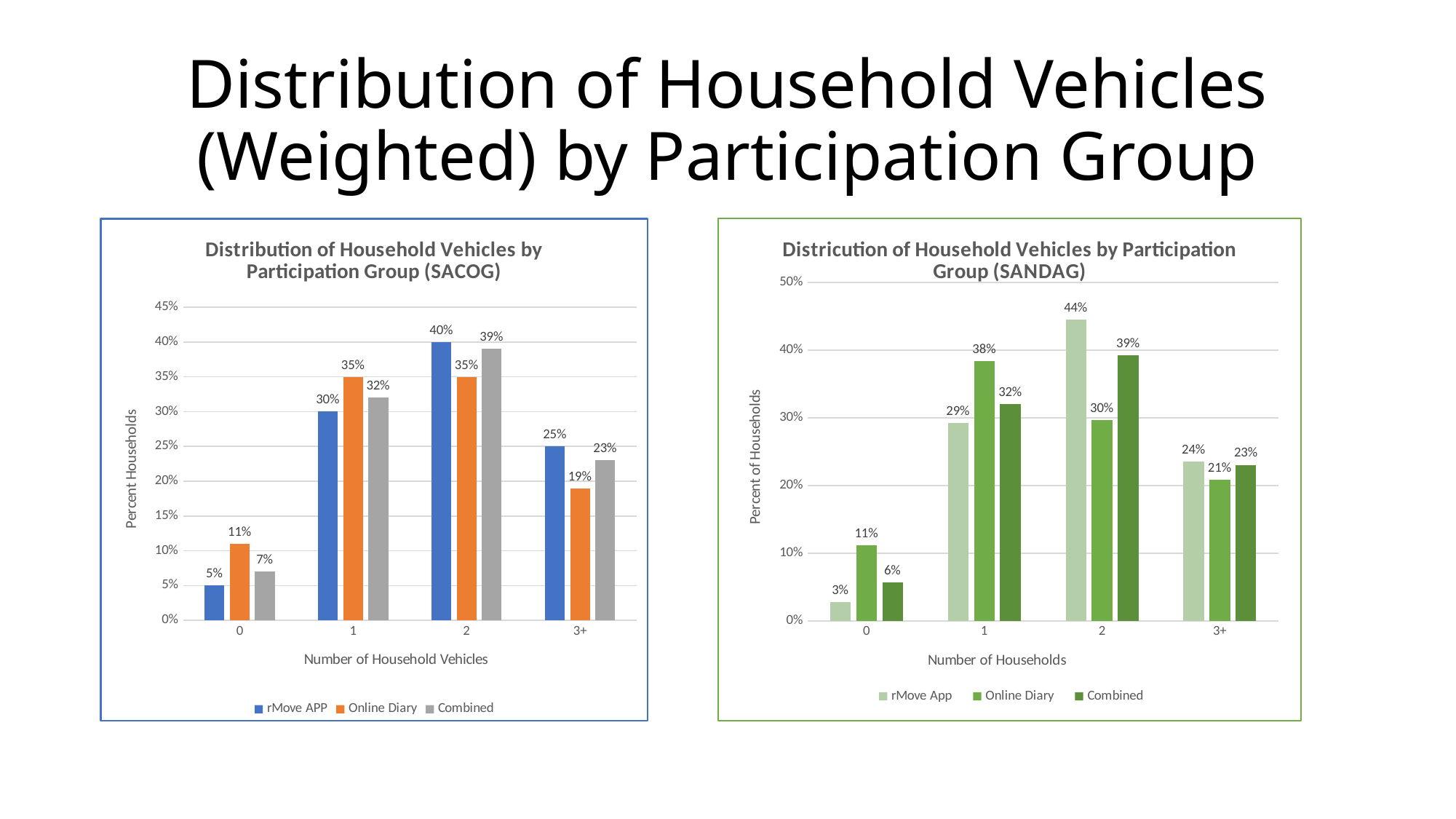
In the SACOG chart, which number of household vehicles has the lowest Online Diary value? 0 In the SANDAG chart, which number of household vehicles has the highest rMove App value? 2 In the SANDAG chart, what is the difference between the rMove App and Online Diary values at 2 household vehicles? 14% How many series does the legend of the SANDAG chart list? 3 In the SACOG chart, what is the value for rMove APP at 2 household vehicles? 40% In the SANDAG chart, which is larger at 0 household vehicles: rMove App or Combined? Combined What kind of chart is the SACOG chart? Bar chart What is the x-axis label of the SANDAG chart? Number of Households In the SANDAG chart, what is the value for Online Diary at 1 household vehicle? 38% In the SACOG chart, what is the difference between the rMove APP and Online Diary values at 3+ household vehicles? 6% How many number-of-household-vehicles categories does the SACOG chart show? 4 In the SACOG chart, what is the Combined value for 3+ household vehicles? 23%